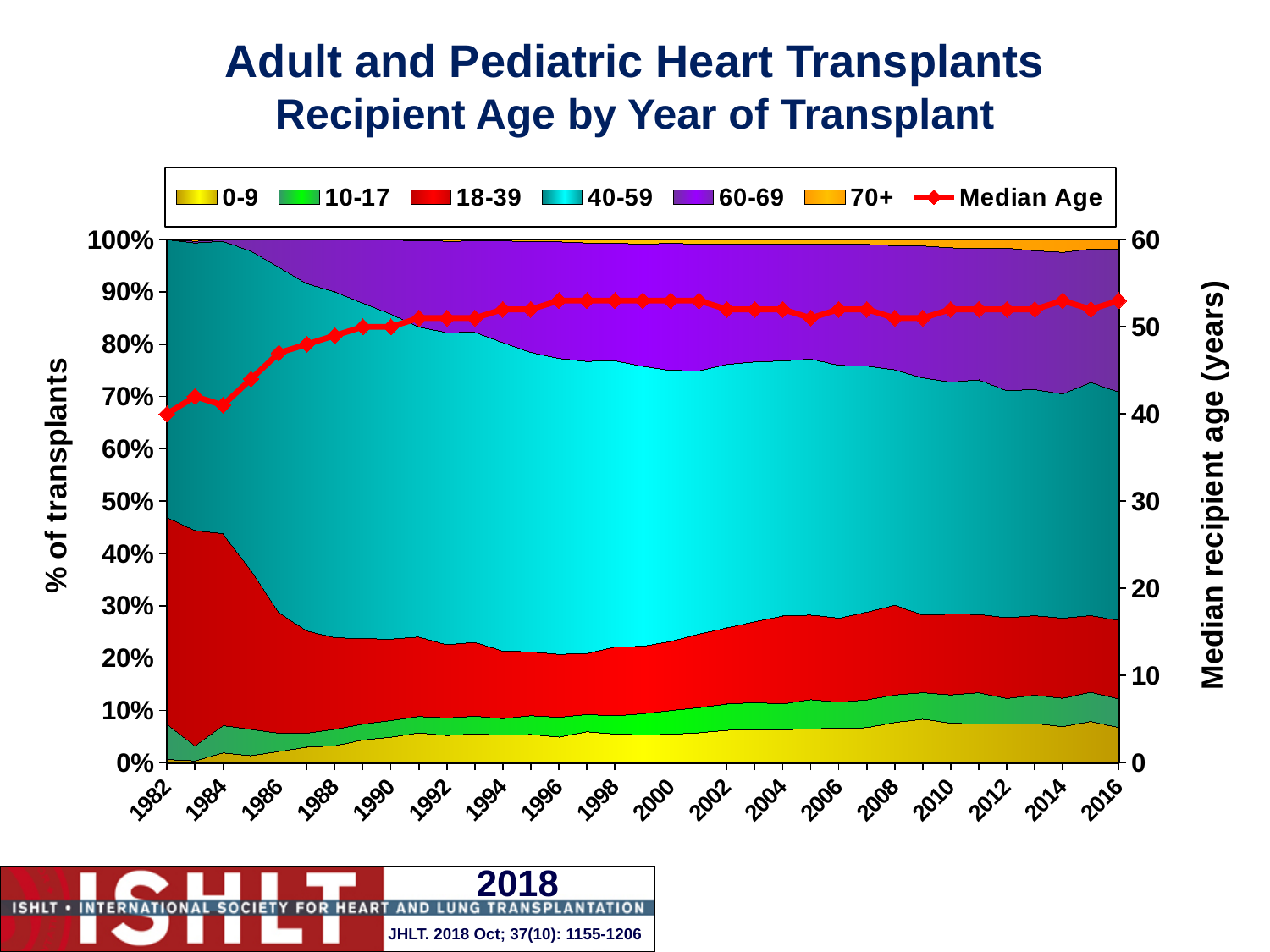
Is the share of transplants in recipients aged 18-39 larger in 1982 or in 2016? 1982 Is the share of transplants in recipients aged 0-9 in 1982 greater or less than 5%? less How many year labels are shown on the x axis? 18 Is the median recipient age in 2016 greater or less than 50 years? greater How many series does the legend list? 7 Is the share of transplants in recipients aged 60-69 larger in 1982 or in 2016? 2016 What is the title of the right-hand vertical axis? Median recipient age (years) Does the median recipient age rise or fall from 1982 to 2016? Rises In 1982, is the combined share of recipients aged 0-39 greater or less than 40%? greater What kind of chart is shown on the slide? Stacked area chart with a line for median age